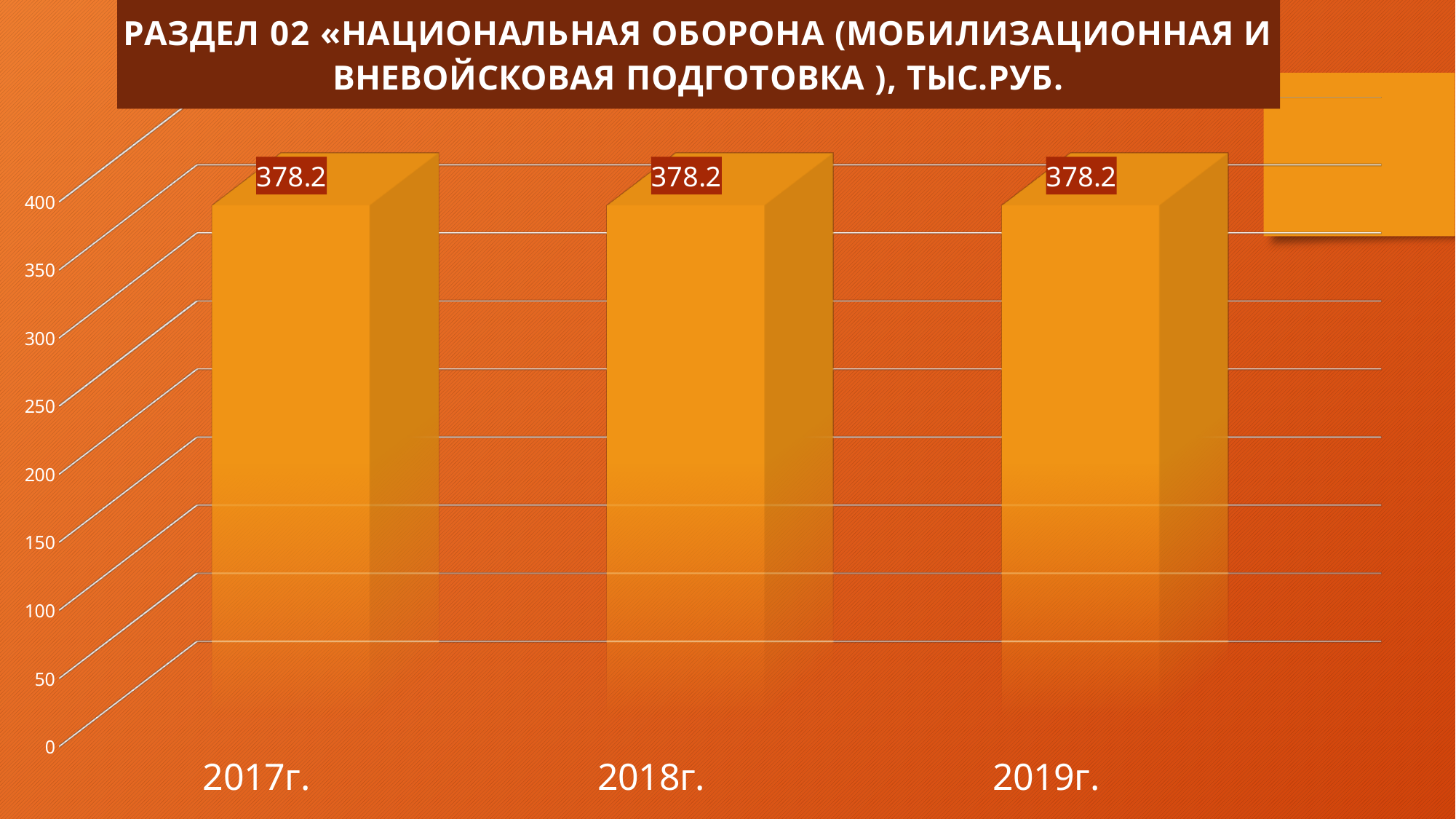
What is the total of the values for 2017г., 2018г. and 2019г.? 1134.6 Is the value for 2018г. greater or less than 350? greater What kind of chart is shown on the slide? bar chart Do the values rise, fall or stay the same from 2017г. to 2019г.? stay the same What unit is stated in the chart title? тыс.руб. What is the value for 2017г.? 378.2 What is the value for 2019г.? 378.2 What is the difference between the values for 2019г. and 2017г.? 0 What is the value for 2018г.? 378.2 What is the highest tick value shown on the vertical axis? 400 How many categories are shown on the x axis? 3 Is the value for 2017г. greater or less than 400? less